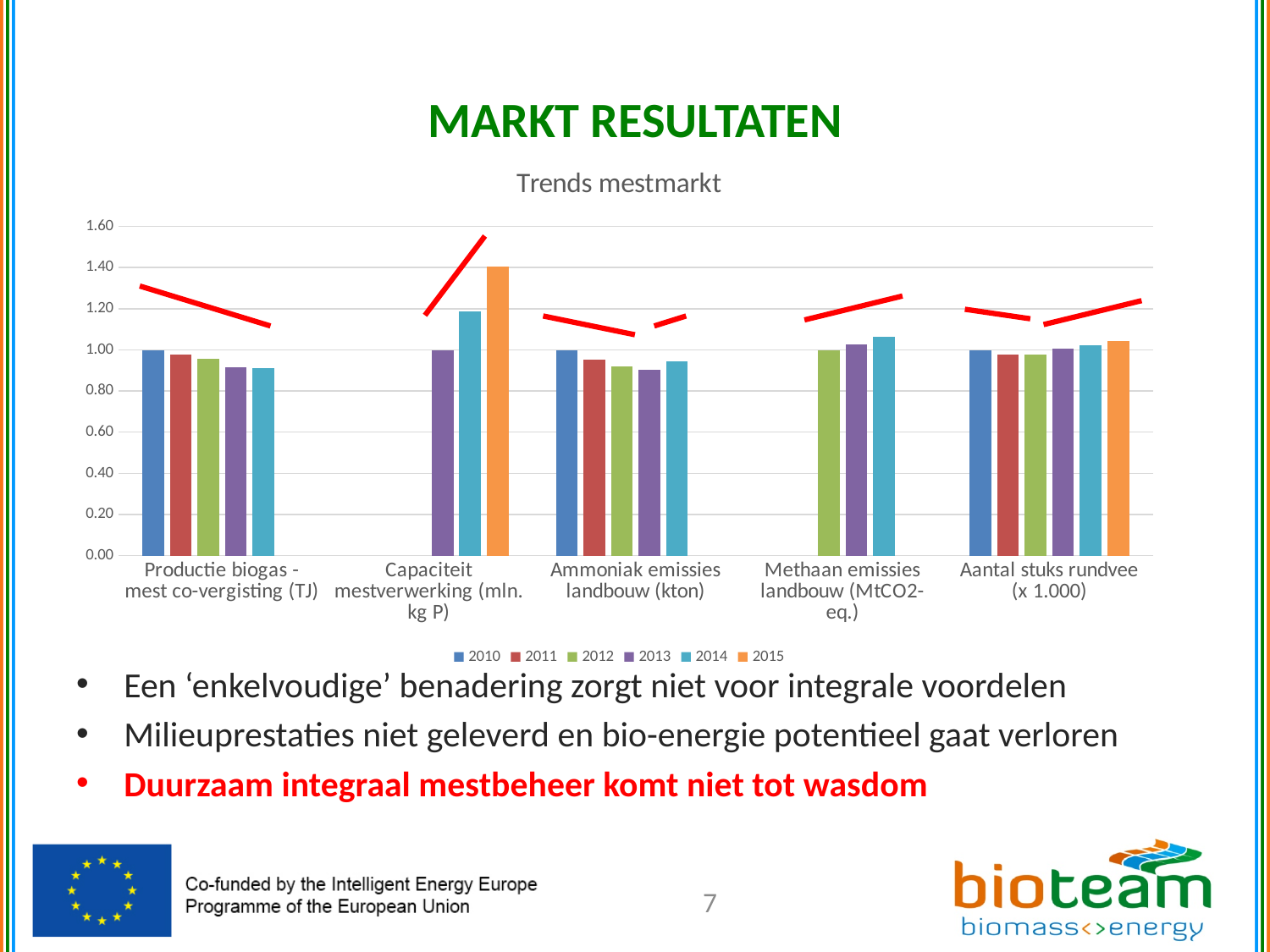
Which is larger: the 2015 value for Capaciteit mestverwerking (mln. kg P) or the 2015 value for Aantal stuks rundvee (x 1.000)? Capaciteit mestverwerking (mln. kg P) Is the 2015 value for Capaciteit mestverwerking (mln. kg P) greater or less than 1.20? greater Do the bars for Productie biogas - mest co-vergisting (TJ) rise or fall from 2010 to 2014? fall Is the 2014 value for Productie biogas - mest co-vergisting (TJ) greater or less than 1.00? less What is the title of the chart? Trends mestmarkt Which category has the tallest bar in the chart? Capaciteit mestverwerking (mln. kg P) Is the 2013 value for Ammoniak emissies landbouw (kton) greater or less than 1.00? less What kind of chart is shown on the slide? bar chart How many categories are shown on the x axis of the chart? 5 What is the 2010 value for Productie biogas - mest co-vergisting (TJ)? 1.00 How many series does the legend of the chart list? 6